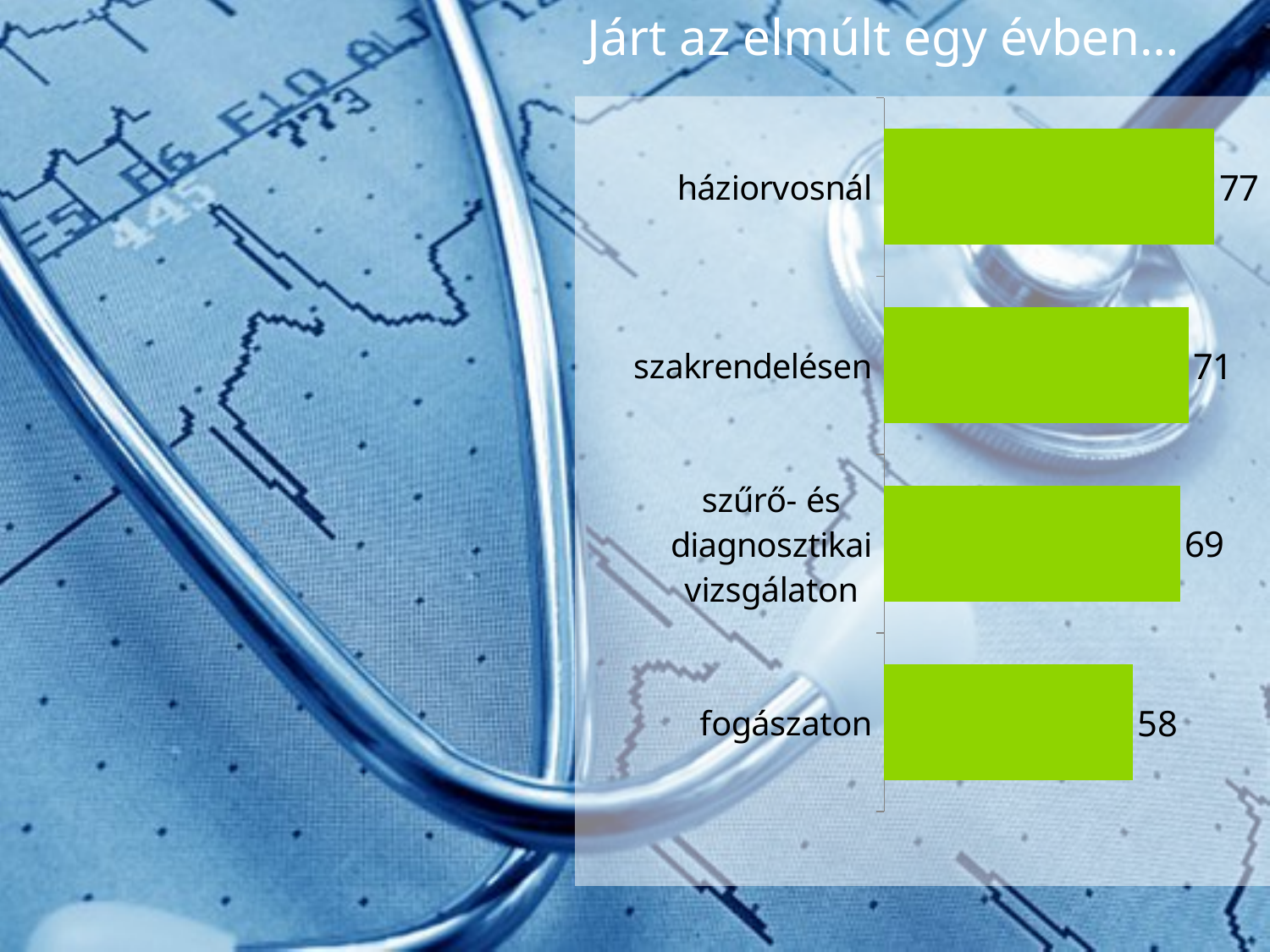
What is the value for szűrő- és diagnosztikai vizsgálaton? 69 What is the title of the slide? Járt az elmúlt egy évben… What is the difference between the values for szakrendelésen and szűrő- és diagnosztikai vizsgálaton? 2 What is the value for szakrendelésen? 71 Which category has the highest value? háziorvosnál What kind of chart is shown on the slide? bar chart Which is larger, the value for szakrendelésen or the value for fogászaton? szakrendelésen What is the value for háziorvosnál? 77 What is the difference between the values for háziorvosnál and fogászaton? 19 Which category has the lowest value? fogászaton How many categories are shown in the chart? 4 What is the value for fogászaton? 58